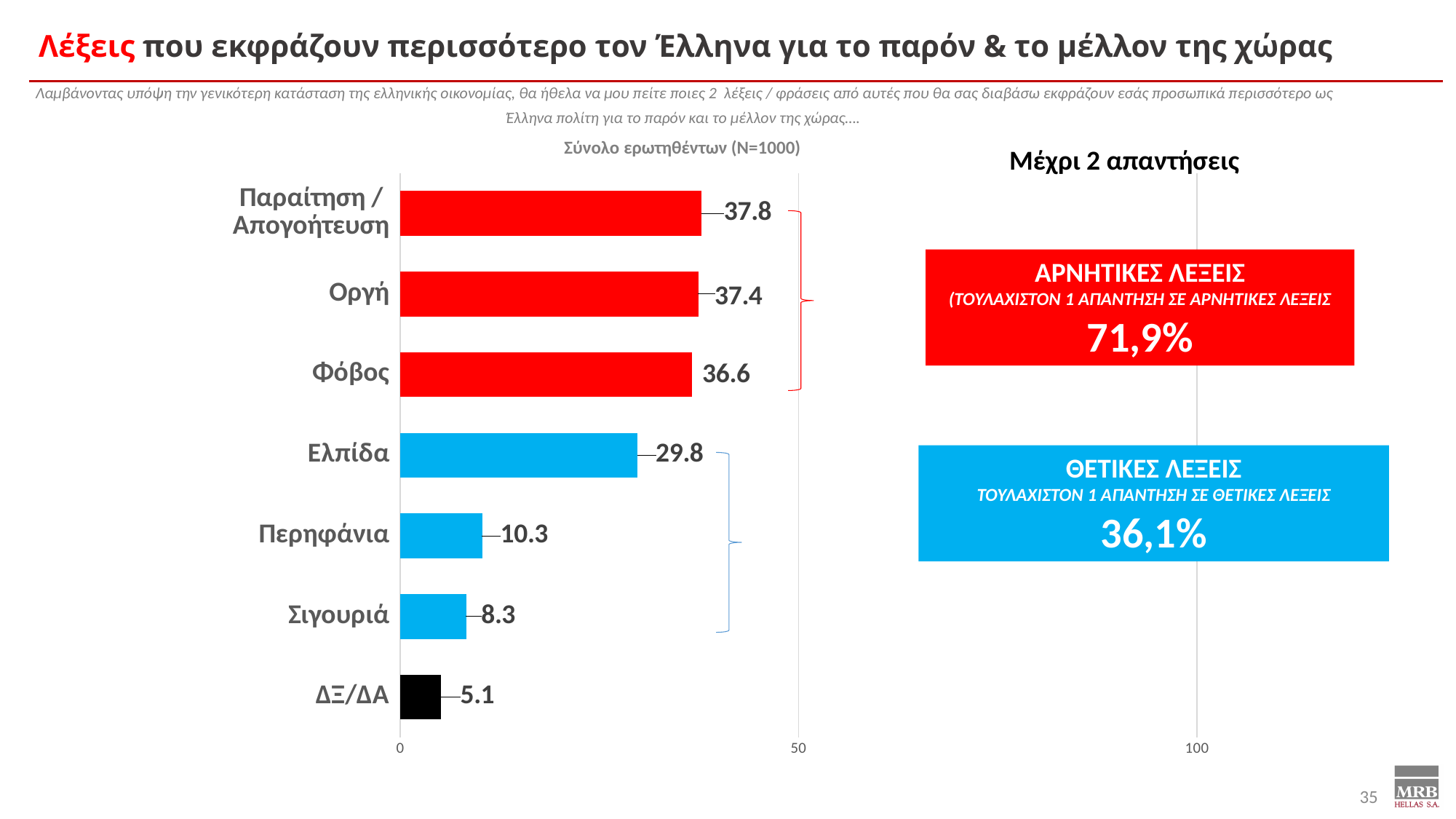
How many categories are shown in the chart? 7 What is the value for Παραίτηση / Απογοήτευση? 37.8 Which category has the lowest value? ΔΞ/ΔΑ Which is larger, the value for Οργή or the value for Ελπίδα? Οργή Which category has the highest value? Παραίτηση / Απογοήτευση What percentage is shown in the red box for ΑΡΝΗΤΙΚΕΣ ΛΕΞΕΙΣ? 71,9% What is the difference between the values for Παραίτηση / Απογοήτευση and Φόβος? 1.2 What is the difference between the values for Ελπίδα and Περηφάνια? 19.5 Is the value for Φόβος greater or less than 50? less What is the value for Σιγουριά? 8.3 What kind of chart is shown on the slide? bar chart What is the value for Ελπίδα? 29.8